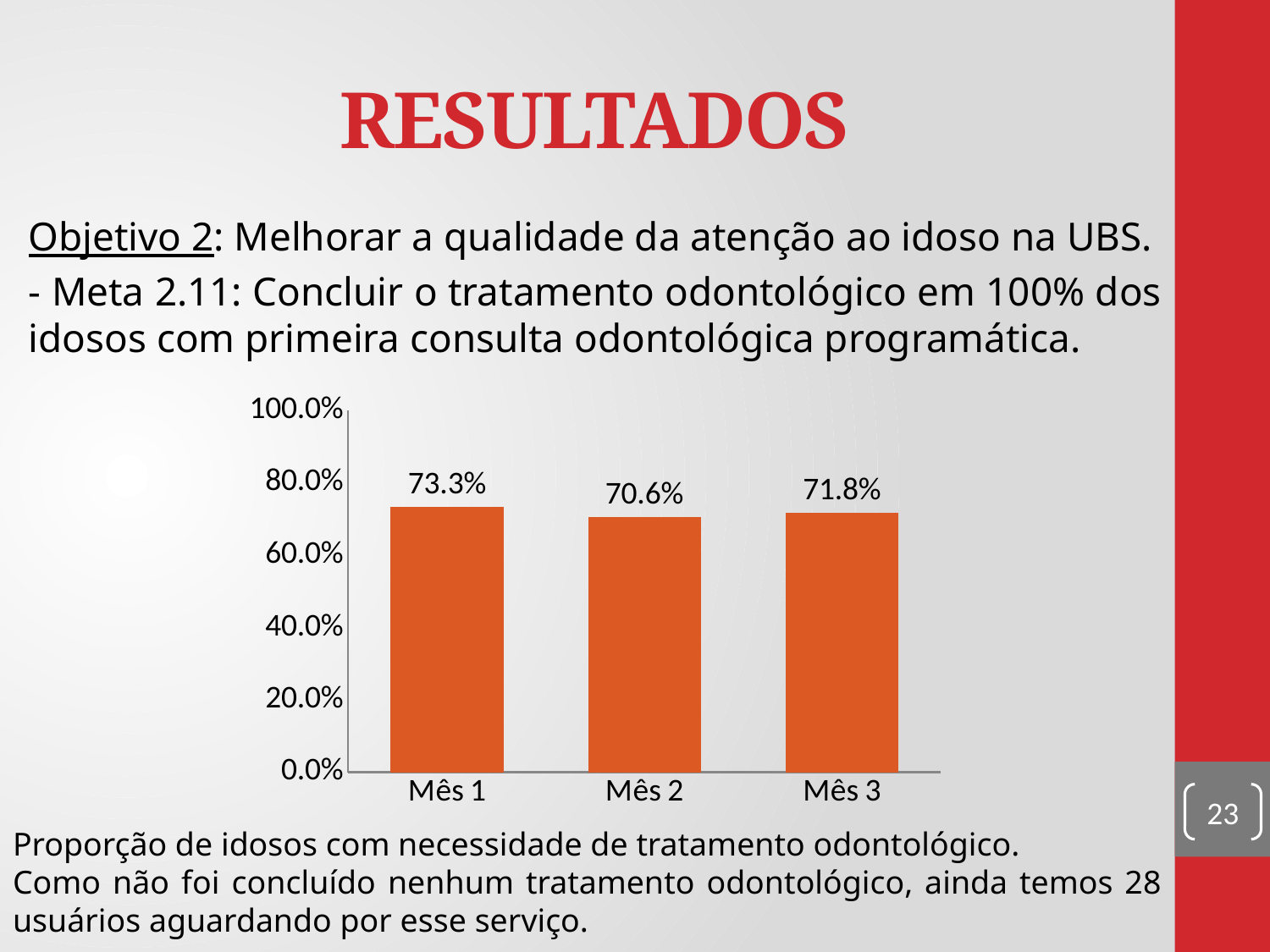
Which month has the highest value? Mês 1 How many months are shown on the x axis? 3 What is the difference between the values for Mês 1 and Mês 2? 2.7% What is the difference between the values for Mês 3 and Mês 2? 1.2% Which month has the lowest value? Mês 2 Which is larger, the value for Mês 1 or the value for Mês 3? Mês 1 What colour are the bars in the chart? orange Is the value for Mês 2 greater or less than 80.0%? less What is the value for Mês 2? 70.6% What is the value for Mês 3? 71.8% What is the value for Mês 1? 73.3% What kind of chart is shown on the slide? bar chart